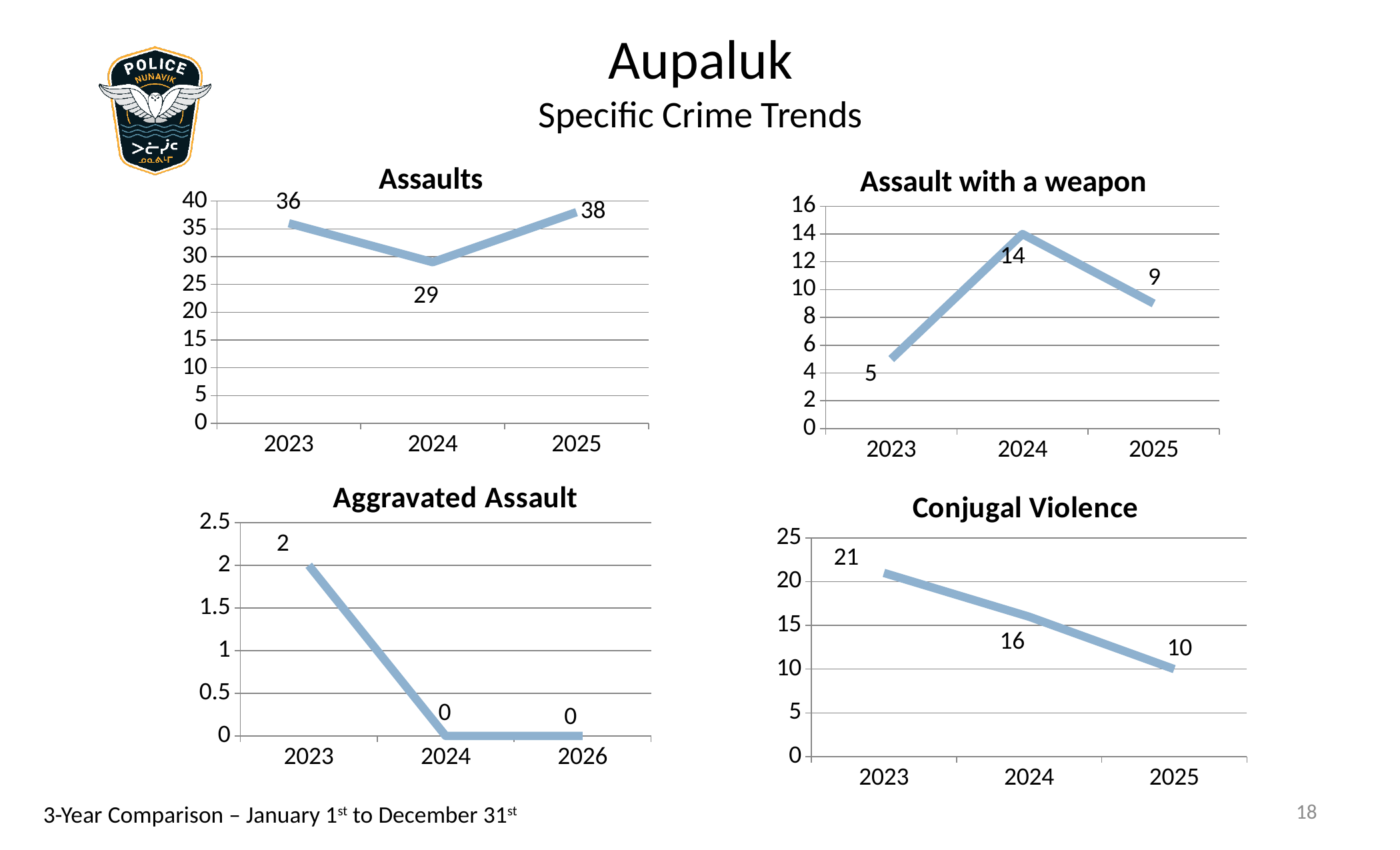
In the Assault with a weapon chart, which year has the highest value? 2024 In the Aggravated Assault chart, what is the value for 2023? 2 In the Aggravated Assault chart, how many data points are plotted? 3 In the Conjugal Violence chart, which is larger, the value for 2023 or the value for 2025? 2023 In the Conjugal Violence chart, what is the value for 2024? 16 In the Conjugal Violence chart, do the values rise or fall from 2023 to 2025? fall In the Assaults chart, what is the value for 2024? 29 In the Assault with a weapon chart, what is the value for 2023? 5 In the Assault with a weapon chart, what is the difference between the 2024 and 2025 values? 5 What kind of chart is the Conjugal Violence chart? line chart In the Assaults chart, what is the difference between the 2025 and 2023 values? 2 In the Assaults chart, which year has the highest value? 2025